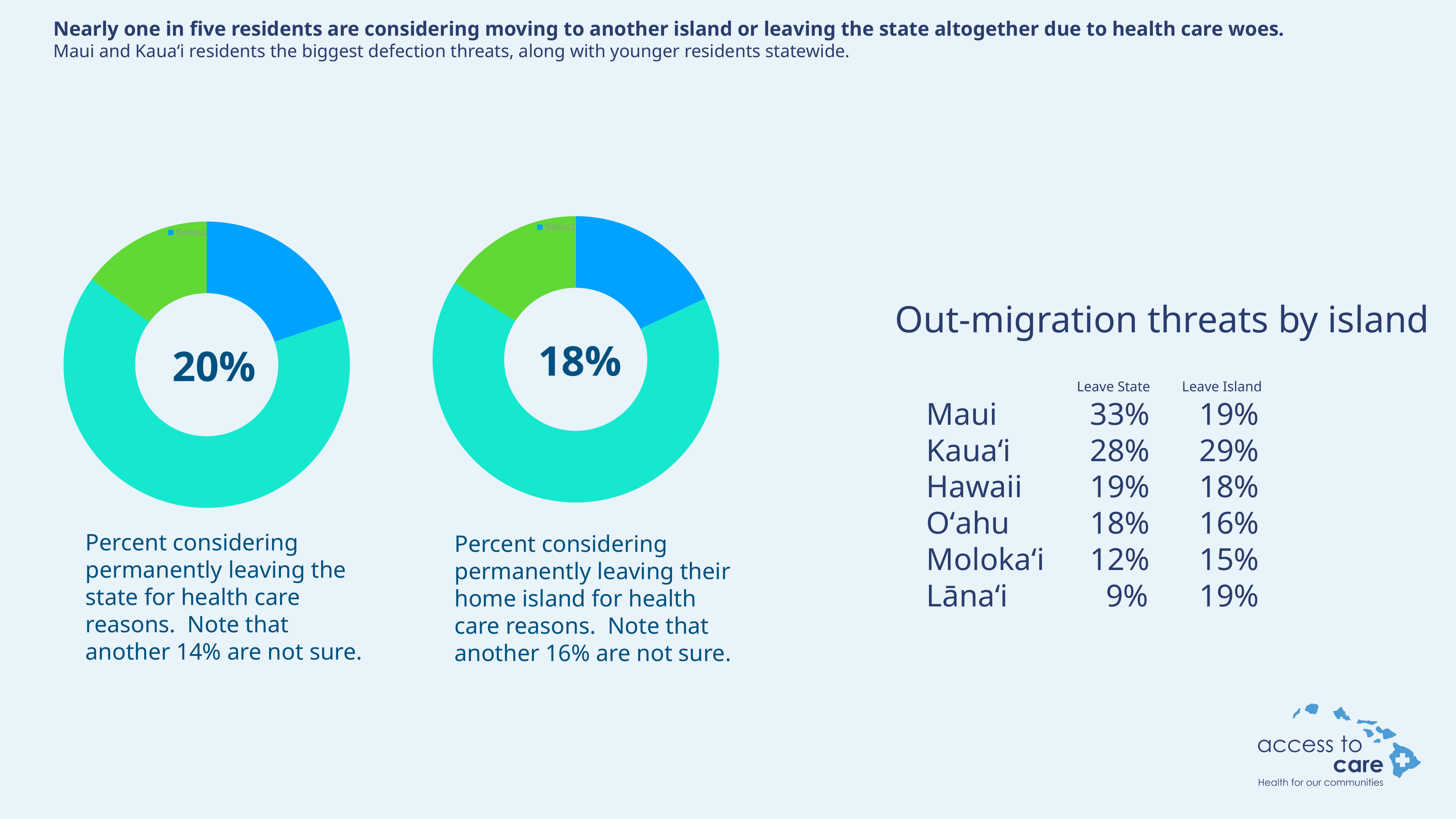
How many slices does the left donut chart have? 3 In the right chart, what percentage is shown in the centre of the donut? 18% According to the caption under the right chart, what percentage of residents are not sure about leaving their home island? 16% What kind of chart is the chart on the left of the slide? pie chart (donut) What is the difference between the centre value of the left chart (20%) and the centre value of the right chart (18%)? 2 percentage points According to the caption under the left chart, what percentage of residents are not sure about leaving the state? 14% In the left chart, is the blue slice larger or smaller than the green slice? larger Which chart shows the larger centre value, the left chart (leaving the state) or the right chart (leaving their home island)? the left chart (leaving the state) What colour is the largest slice in the right donut chart? teal In the left chart, what percentage is shown in the centre of the donut? 20% How many pie charts are shown on the slide? 2 How many slices does the right donut chart have? 3